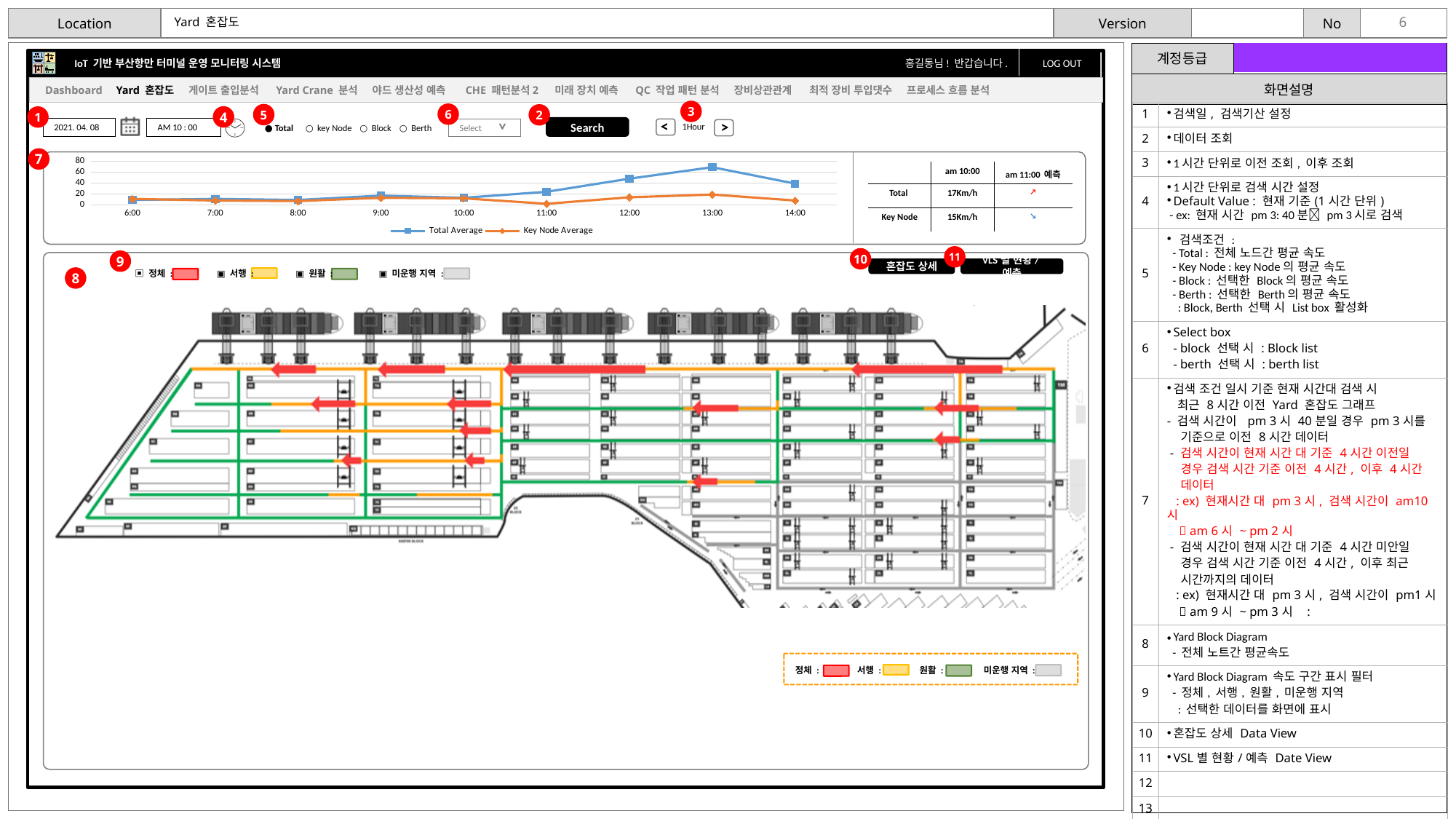
Is the Key Node Average value at 13:00 greater or less than 40? less What is the highest value shown on the y axis of the line chart? 80 How many series does the legend of the line chart list? 2 Is the Total Average value at 6:00 greater or less than 20? less Is the Total Average value at 13:00 greater or less than 60? greater How many time points are plotted along the x axis of the line chart? 9 Does the Total Average series rise or fall between 11:00 and 13:00? rise At 13:00, which series has the larger value, Total Average or Key Node Average? Total Average Does the Total Average series rise or fall between 13:00 and 14:00? fall At which time does the Total Average series reach its highest value? 13:00 What are the two series named in the line chart's legend? Total Average and Key Node Average What kind of chart is shown at the top of the slide? line chart